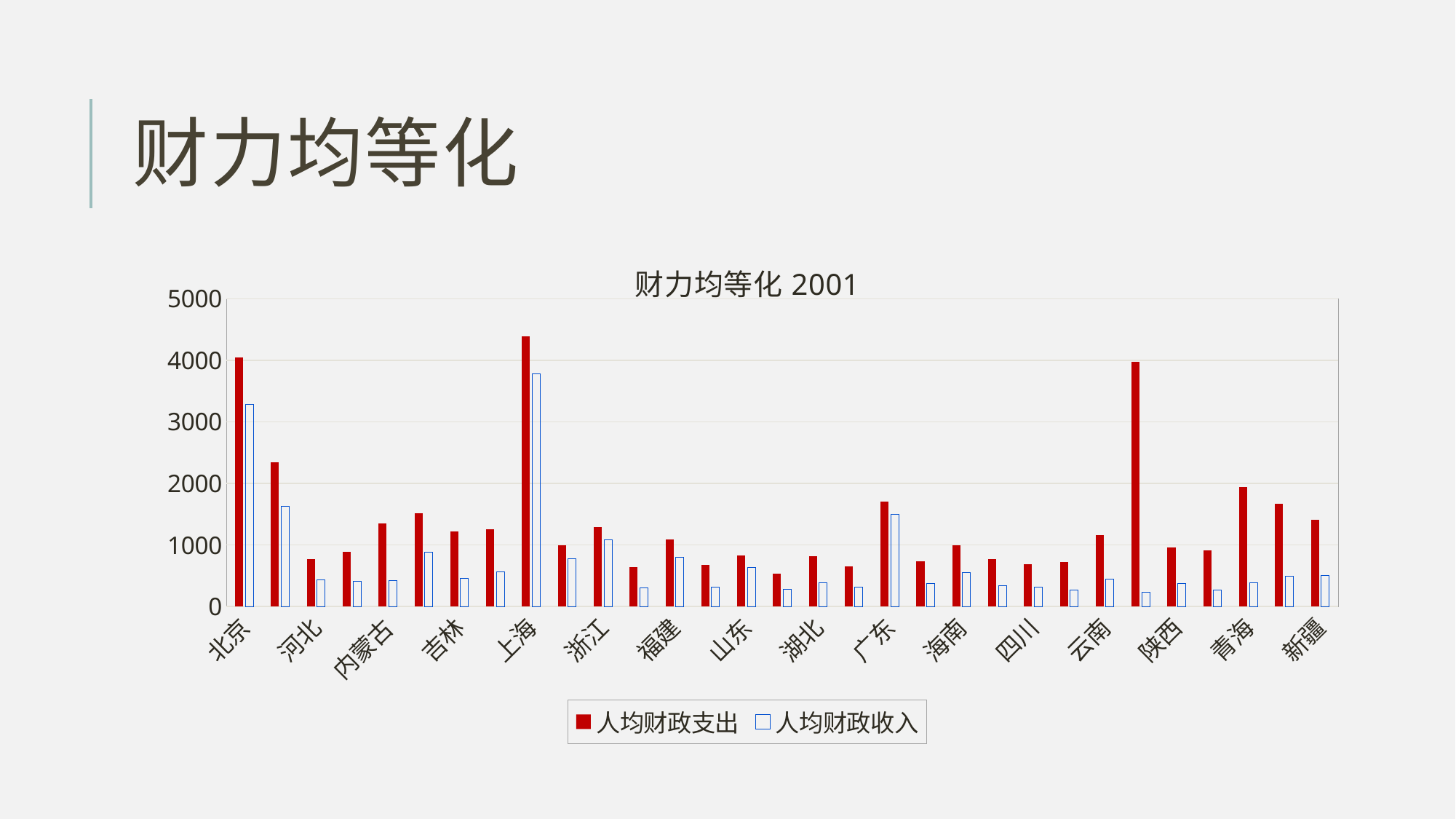
How many provinces/regions are shown on the x axis? 16 Which series is drawn in solid red bars? 人均财政支出 Which region has the highest 人均财政收入? 上海 Is the 人均财政支出 value for 河北 greater or less than 2000? less Which is larger, the 人均财政支出 for 北京 or for 河北? 北京 Is the 人均财政收入 value for 广东 greater or less than 1000? greater Is the 人均财政支出 value for 上海 greater or less than 4000? greater What is the title of the chart? 财力均等化 2001 Which region has the highest 人均财政支出? 上海 What kind of chart is shown on the slide? bar chart How many series does the legend list? 2